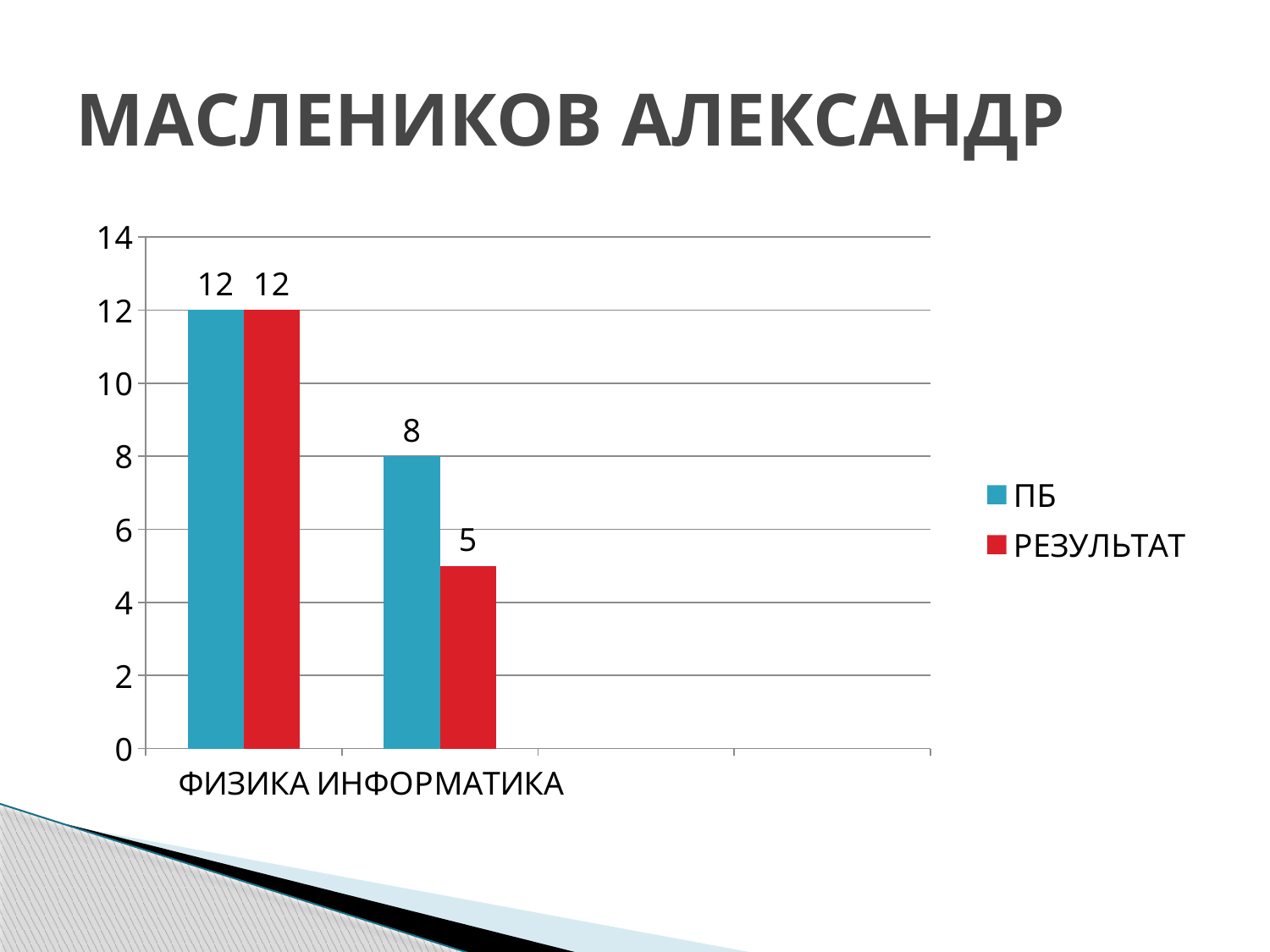
How many categories are shown on the x axis? 2 What is the ПБ value for ФИЗИКА? 12 How many series does the legend list? 2 Which category has the highest ПБ value? ФИЗИКА What is the РЕЗУЛЬТАТ value for ИНФОРМАТИКА? 5 What kind of chart is shown on the slide? bar chart Which category has the lowest РЕЗУЛЬТАТ value? ИНФОРМАТИКА For ИНФОРМАТИКА, which is larger: ПБ or РЕЗУЛЬТАТ? ПБ What is the difference between the ПБ and РЕЗУЛЬТАТ values for ИНФОРМАТИКА? 3 What is the РЕЗУЛЬТАТ value for ФИЗИКА? 12 Which series is shown in red in the legend? РЕЗУЛЬТАТ What is the ПБ value for ИНФОРМАТИКА? 8